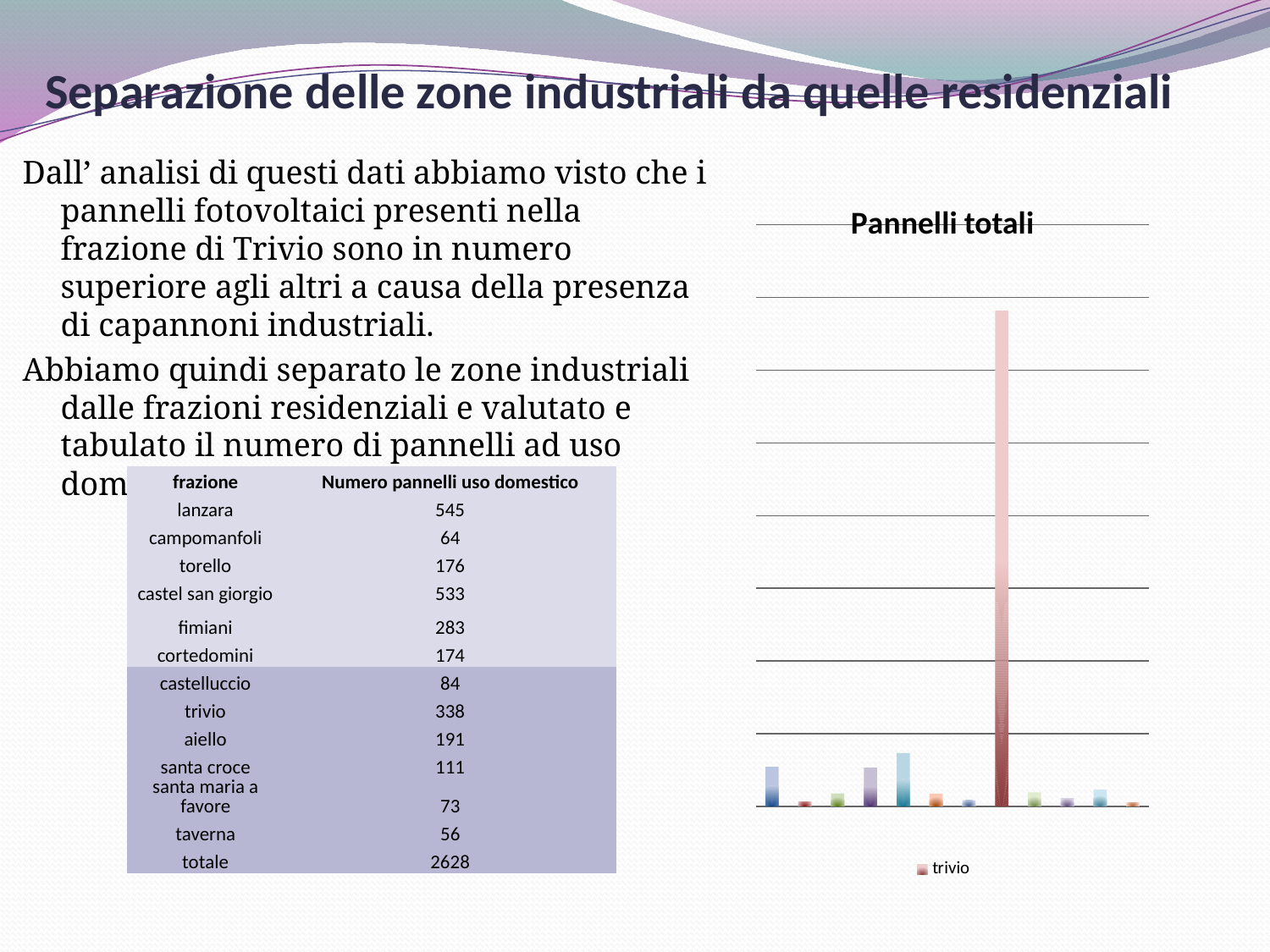
What is the entry shown in the chart's legend? trivio How many bars are plotted in the chart? 12 What is the title of the chart on the slide? Pannelli totali How many entries does the chart's legend list? 1 What kind of chart is shown on the slide? bar chart Which category has the tallest bar in the chart? trivio